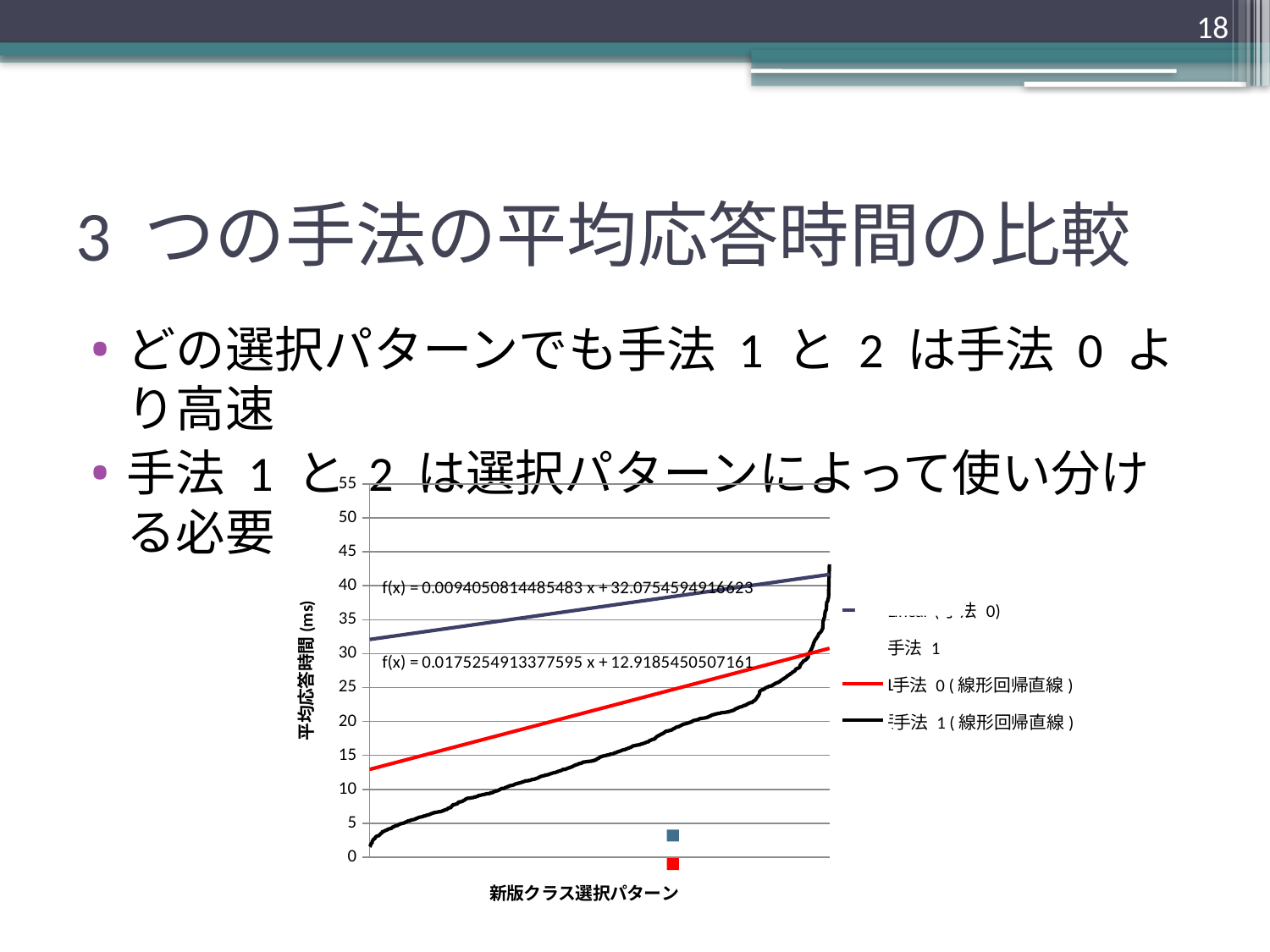
Is the value of the black curve at the left end of the chart greater or less than 5? less What is the intercept (constant term) in the regression equation printed for the upper (dark blue) line? 32.0754594916623 What kind of chart is shown on the slide? line chart What is the slope coefficient in the regression equation printed for the lower (red) line? 0.0175254913377595 Does the black curve rise or fall as it moves from left to right along the x axis? rises Is the value of the black curve at the right end of the chart greater or less than 40? greater Is the value of the dark blue regression line at the left end of the chart greater or less than 30? greater What is the label of the vertical axis of the chart? 平均応答時間 (ms) What is the label of the horizontal axis of the chart? 新版クラス選択パターン What is the highest tick value shown on the vertical axis? 55 At the left end of the chart, which line is higher: the dark blue line or the red line? the dark blue line